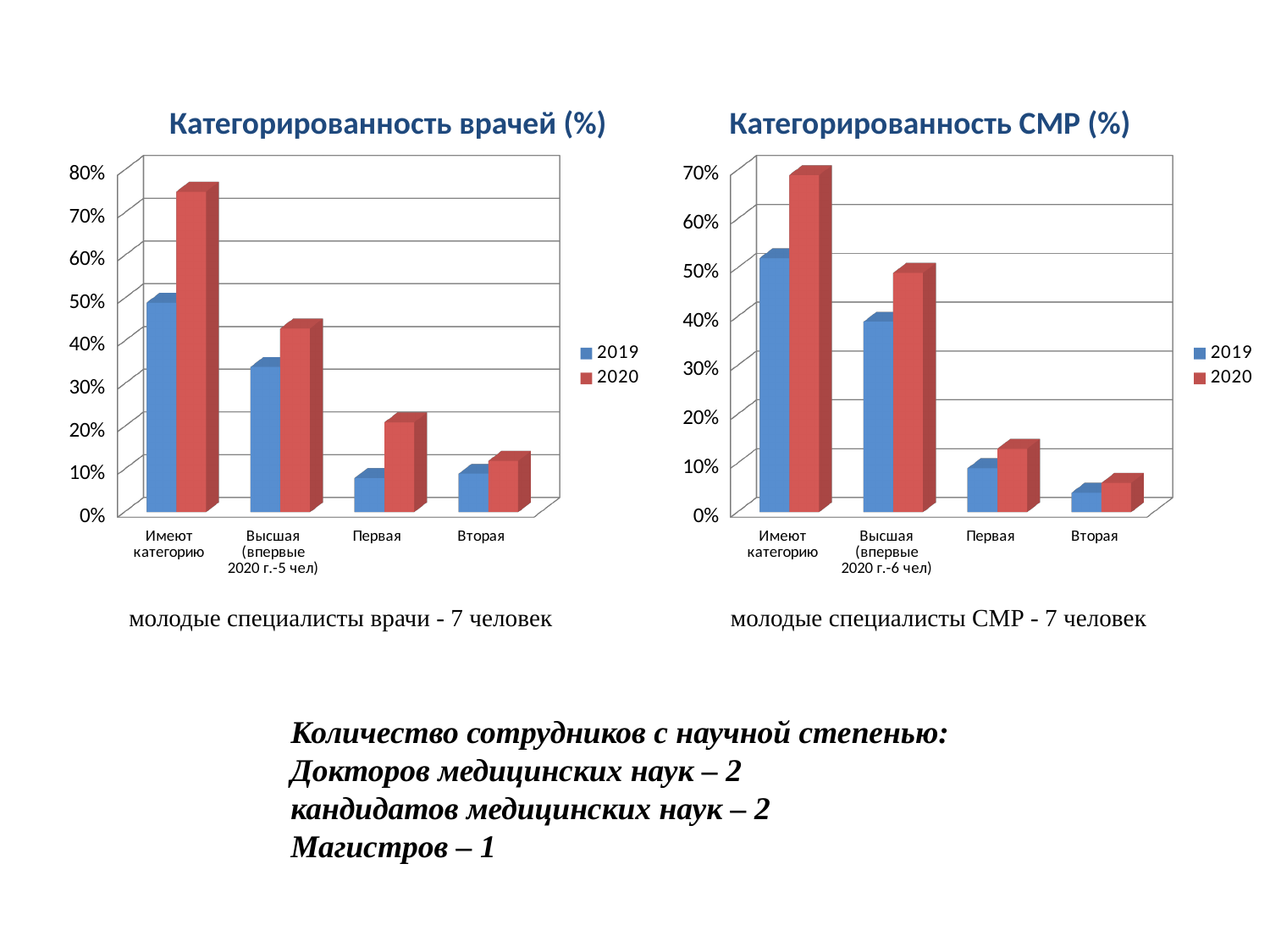
In the left chart "Категорированность врачей (%)", which is larger for "Первая": the 2019 value or the 2020 value? 2020 In the right chart "Категорированность СМР (%)", do the 2020 values rise or fall from left to right along the x axis? fall How many categories are shown on the x axis of the left chart "Категорированность врачей (%)"? 4 How many series does the legend of the right chart "Категорированность СМР (%)" list? 2 In the left chart "Категорированность врачей (%)", which category has the highest 2020 value? Имеют категорию In the left chart "Категорированность врачей (%)", is the 2019 value for "Первая" greater or less than 10%? less In the right chart "Категорированность СМР (%)", is the 2019 value for "Вторая" greater or less than 10%? less What kind of chart is the left chart titled "Категорированность врачей (%)"? bar chart In the right chart "Категорированность СМР (%)", is the 2020 value for "Имеют категорию" greater or less than 60%? greater In the right chart "Категорированность СМР (%)", which category has the lowest 2019 value? Вторая